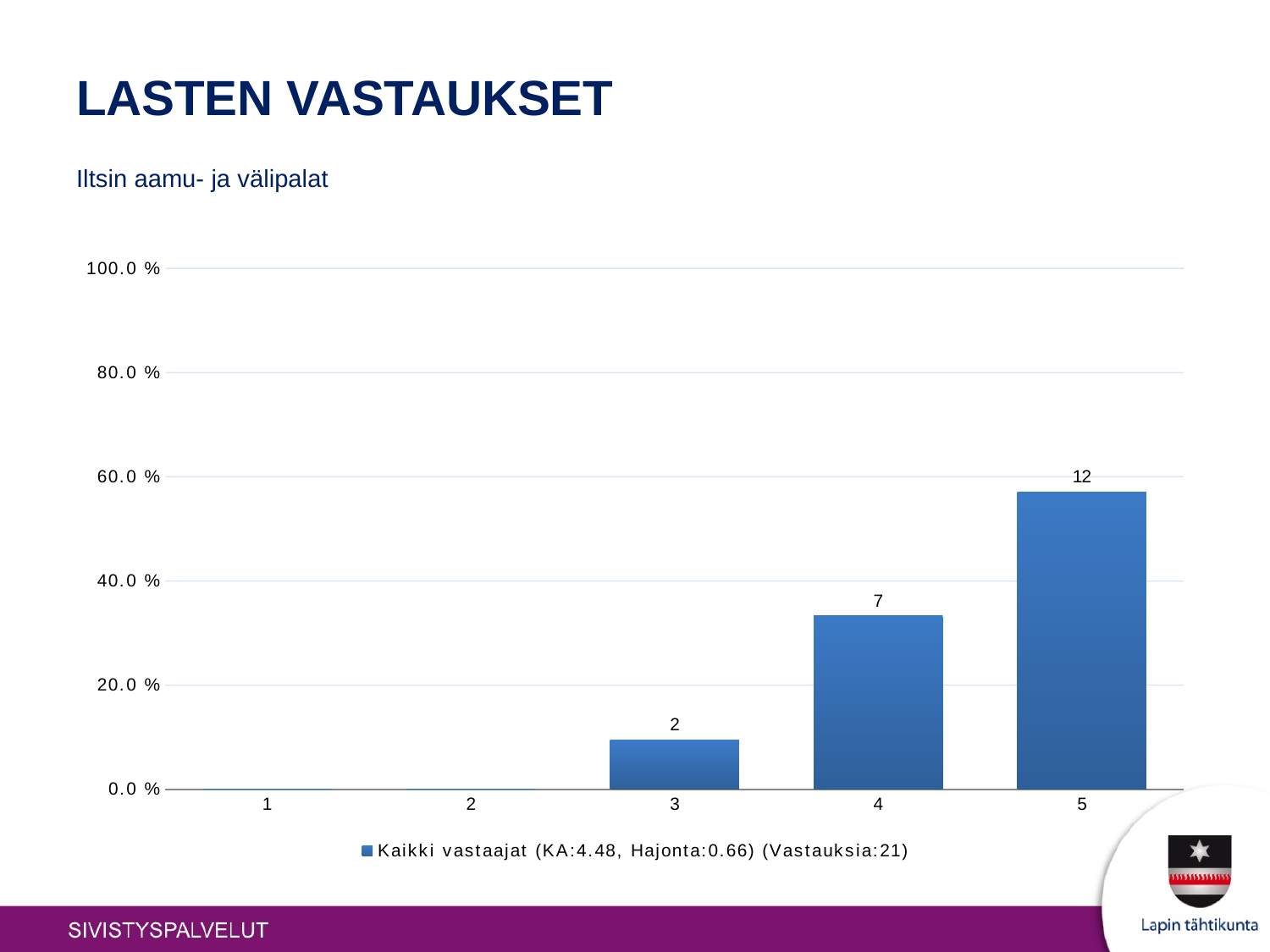
Do the bar heights rise or fall from category 1 to category 5? rise Which bar is taller, category 3 or category 4? 4 What is the data label on the bar for category 5? 12 What kind of chart is shown on the slide? bar chart What is the data label on the bar for category 4? 7 How many categories are shown on the x axis? 5 What is the data label on the bar for category 3? 2 Is the value for category 3 greater or less than 20.0 %? less Is the value for category 5 greater or less than 40.0 %? greater Which of the labelled bars (3, 4 or 5) is the smallest? 3 What is the difference between the data labels for category 5 and category 4? 5 Which category has the highest bar? 5